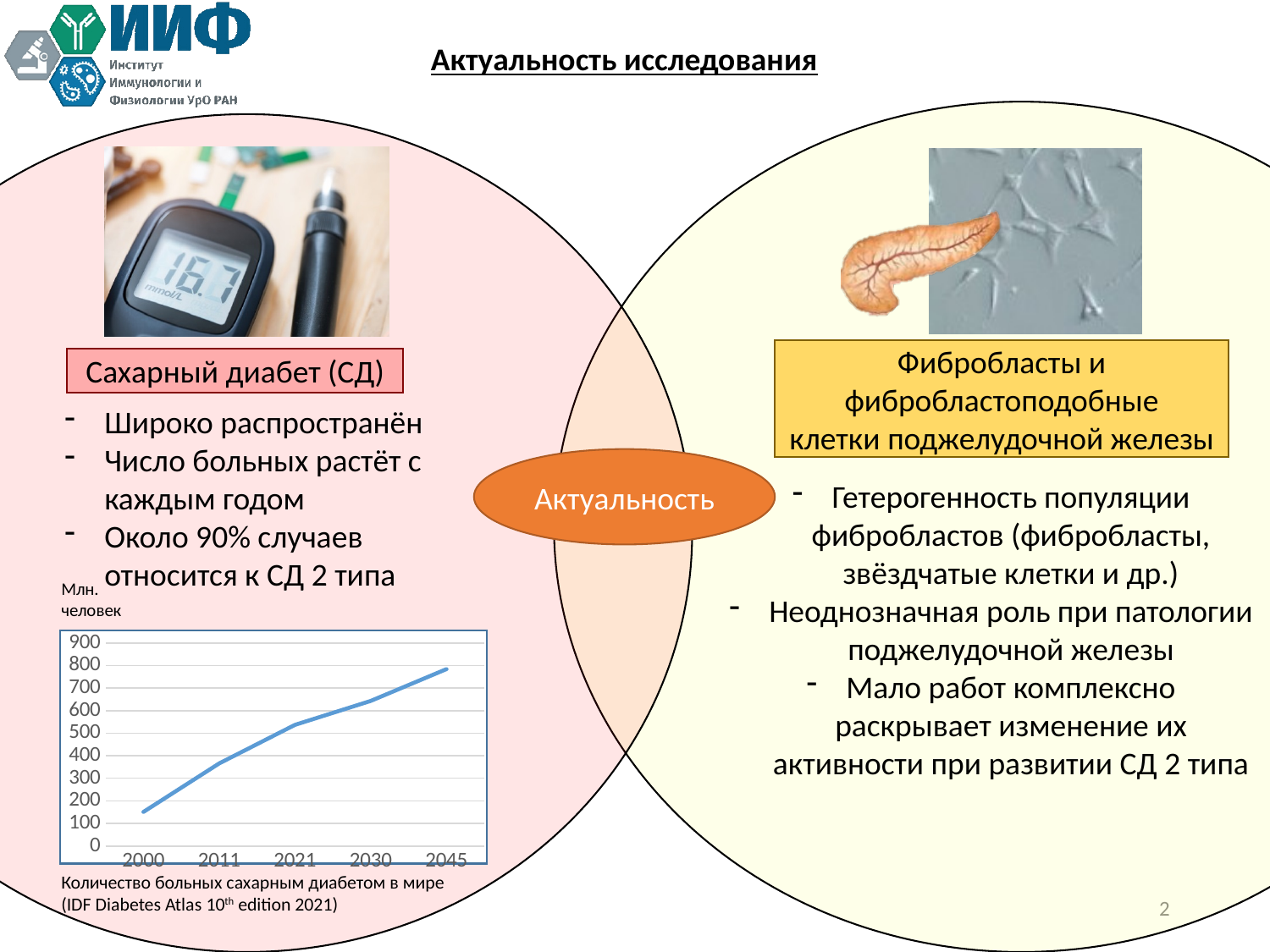
Is the value for 2011 greater or less than 400? less Do the values in the chart rise or fall from 2000 to 2045? rise What kind of chart is shown on the slide? line chart Is the value for 2000 greater or less than 200? less Which year has the lowest value in the chart? 2000 How many years are marked on the x axis of the chart? 5 Is the value for 2045 greater or less than 700? greater Which is larger, the value for 2030 or the value for 2011? 2030 Which year has the highest value in the chart? 2045 What is the highest tick value shown on the y axis of the chart? 900 What unit is given for the y axis of the chart? Млн. человек